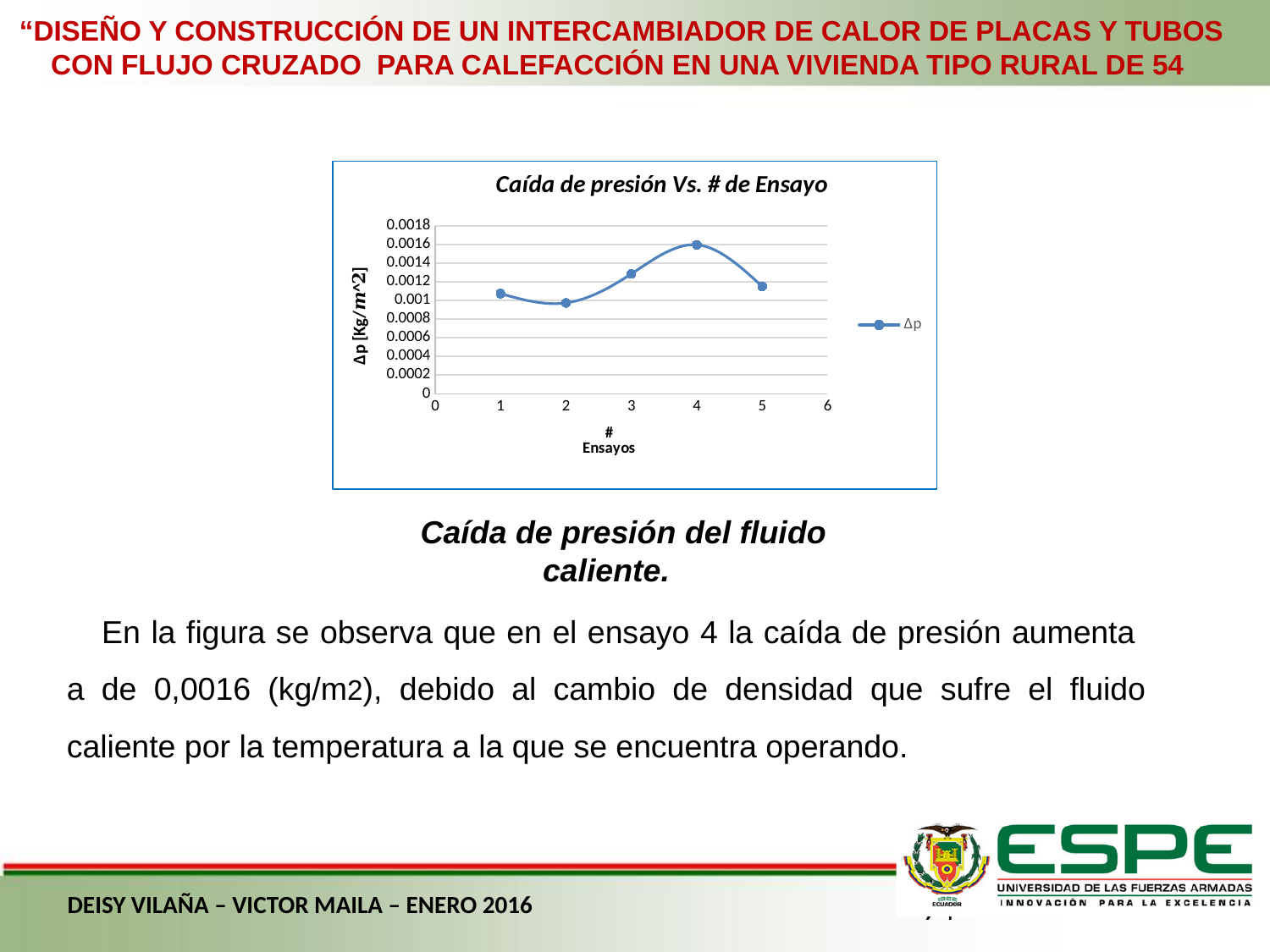
What is the value of Δp at ensayo 4? 0.0016 Which has a larger Δp value, ensayo 3 or ensayo 5? Ensayo 3 How many data points are plotted on the chart? 5 At which ensayo number is the pressure drop (Δp) highest? 4 Is the value of Δp at ensayo 3 greater or less than 0.0012? greater What is the title of the chart? Caída de presión Vs. # de Ensayo Is the value of Δp at ensayo 2 greater or less than 0.0012? less How many series does the legend list? 1 At which ensayo number is the pressure drop (Δp) lowest? 2 What label does the legend show for the plotted series? Δp Does the Δp value rise or fall from ensayo 2 to ensayo 4? Rise What kind of chart is shown on the slide? Line chart